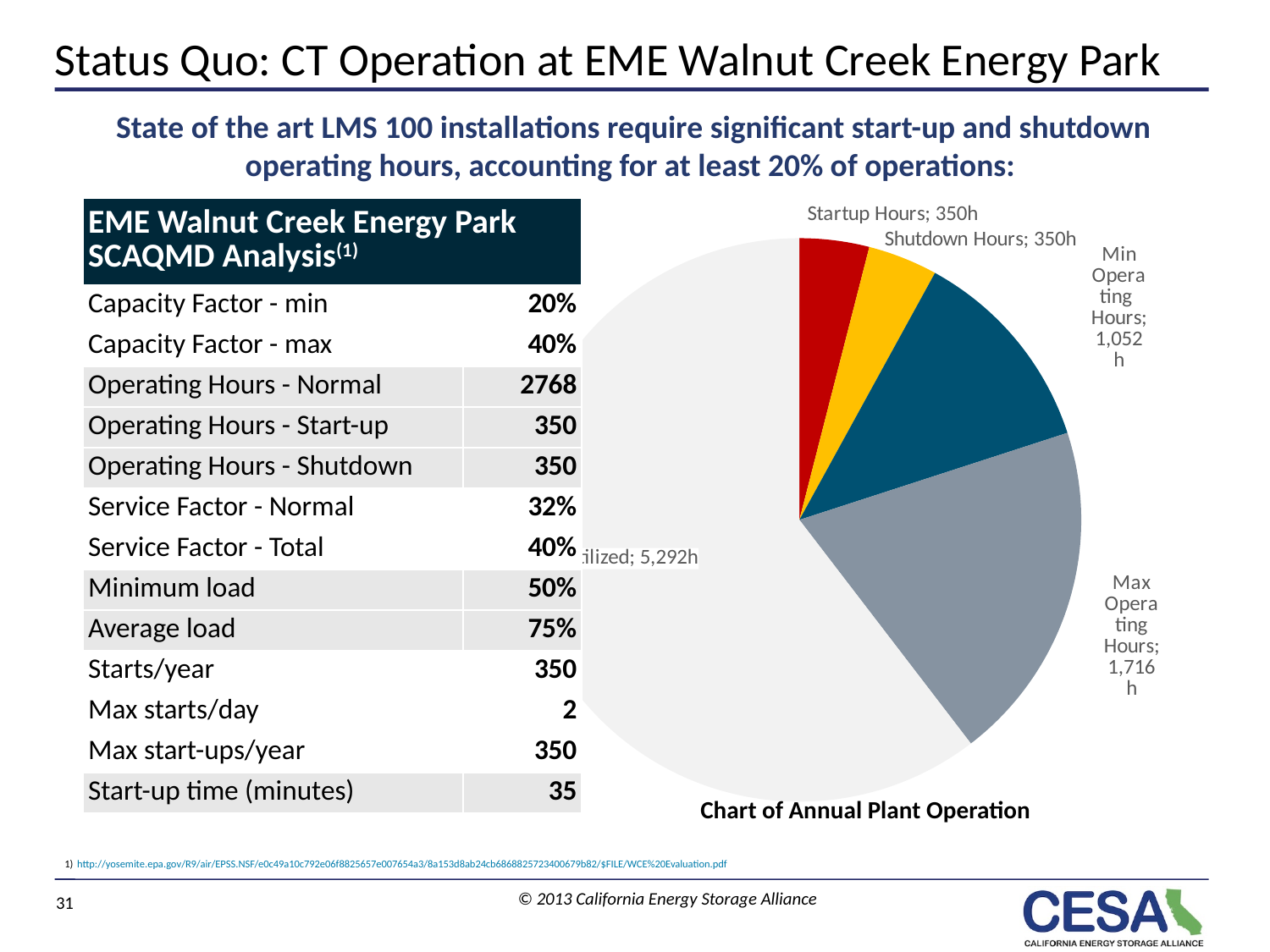
What is the title of the pie chart on the slide? Chart of Annual Plant Operation How many slices does the Chart of Annual Plant Operation have? 5 In the Chart of Annual Plant Operation, how many hours are shown for Startup Hours? 350h In the Chart of Annual Plant Operation, what value is shown for Min Operating Hours? 1,052 h In the Chart of Annual Plant Operation, what value is labelled on the largest, light grey slice? 5,292h In the Chart of Annual Plant Operation, are Startup Hours and Shutdown Hours equal? Yes, both 350h In the Chart of Annual Plant Operation, what colour is the Startup Hours slice? Red In the Chart of Annual Plant Operation, what value is shown for Max Operating Hours? 1,716 h In the Chart of Annual Plant Operation, which slice is the smallest among the labelled operating categories: Min Operating Hours or Max Operating Hours? Min Operating Hours In the Chart of Annual Plant Operation, how many more hours are Max Operating Hours than Min Operating Hours? 664 h In the Chart of Annual Plant Operation, how many hours are shown for Shutdown Hours? 350h What kind of chart is the Chart of Annual Plant Operation? Pie chart